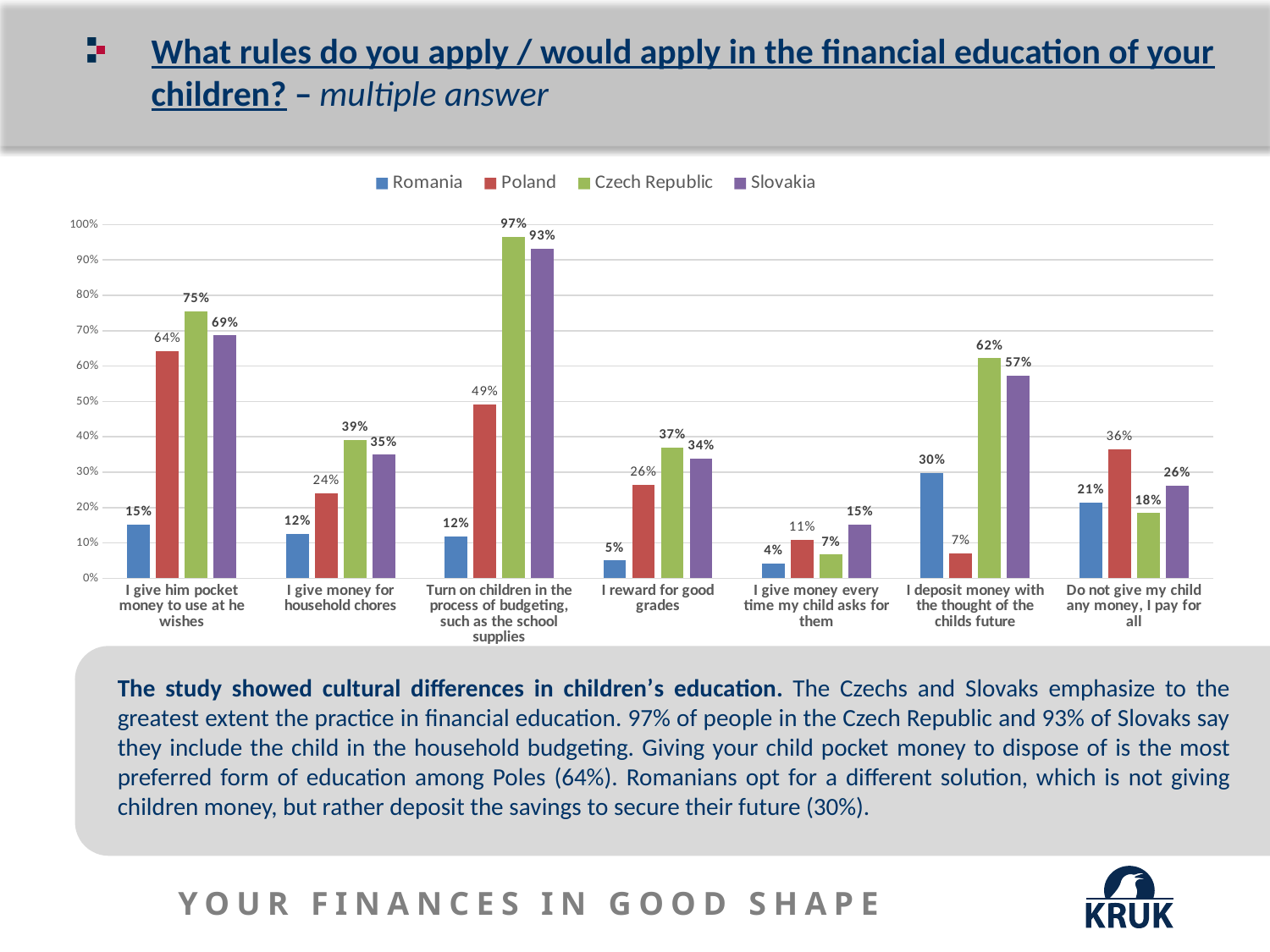
What is the value for Poland for 'I give him pocket money to use at he wishes'? 64% Which colour represents Poland in the chart? Red What percentage of respondents in the Czech Republic say they turn on children in the process of budgeting, such as the school supplies? 97% How many categories (rules) are shown on the x axis? 7 What is the value for Slovakia for 'I give money every time my child asks for them'? 15% Which country has the highest value for 'I reward for good grades'? Czech Republic For 'Do not give my child any money, I pay for all', which is larger: the value for Poland or the value for Slovakia? Poland What is the difference between the Czech Republic and Slovakia values for 'I give him pocket money to use at he wishes'? 6% How many series does the legend list? 4 What kind of chart is shown on the slide? Bar chart Which country has the lowest value for 'I deposit money with the thought of the childs future'? Poland What is the value for Romania for 'I deposit money with the thought of the childs future'? 30%